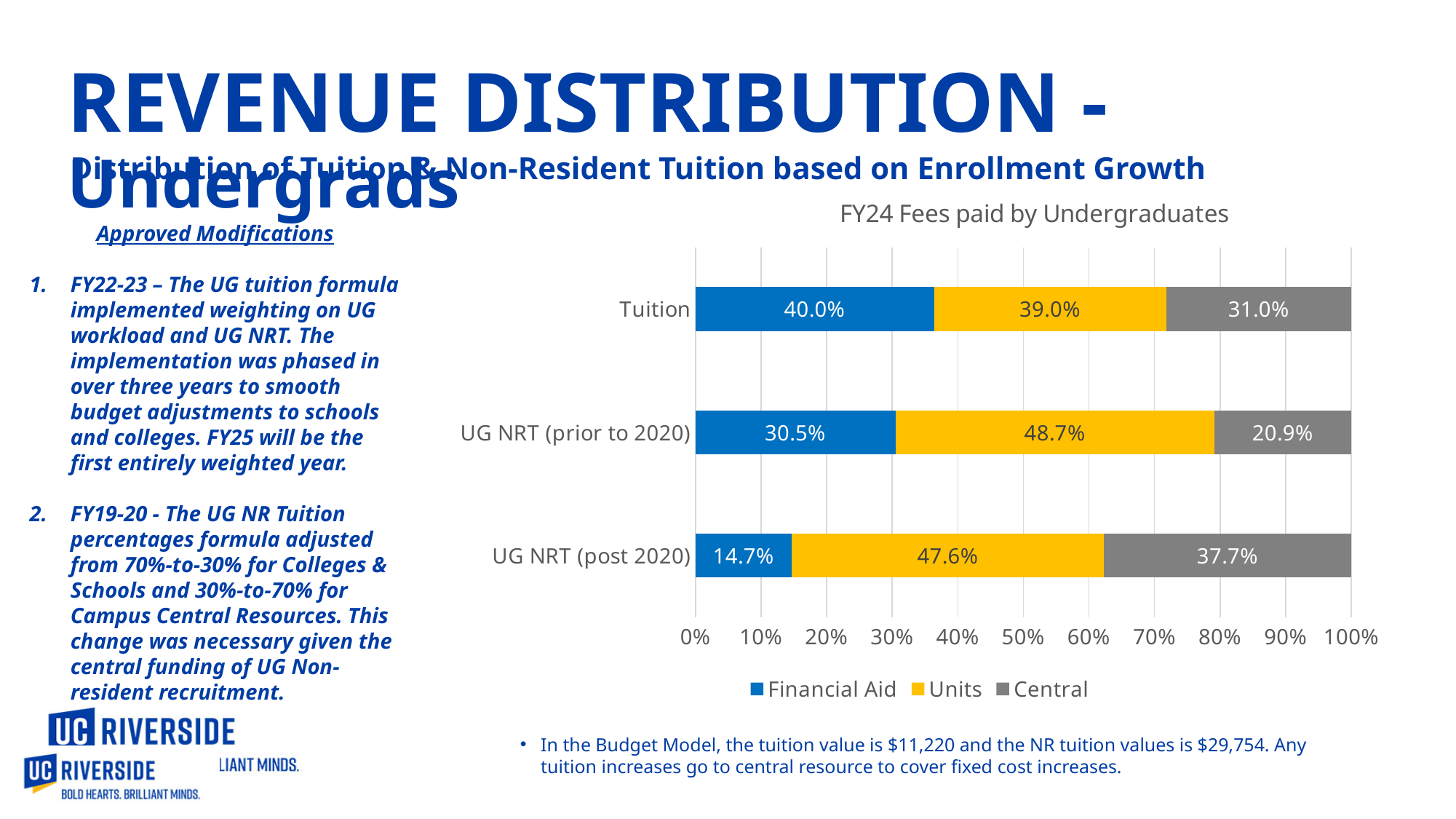
Which category has the highest Central share? UG NRT (post 2020) What is the Financial Aid share for Tuition? 40.0% Which category has the lowest Financial Aid share? UG NRT (post 2020) What is the title of the chart? FY24 Fees paid by Undergraduates Which is larger: the Central share for Tuition or the Central share for UG NRT (prior to 2020)? Tuition How many series does the legend list? 3 What kind of chart is shown? Stacked bar chart What is the Units share for UG NRT (prior to 2020)? 48.7% What is the difference between the Units share for UG NRT (prior to 2020) and the Units share for Tuition? 9.7% Is the Financial Aid share for UG NRT (prior to 2020) greater or less than 20%? greater How many categories are shown on the chart? 3 What is the Central share for UG NRT (post 2020)? 37.7%